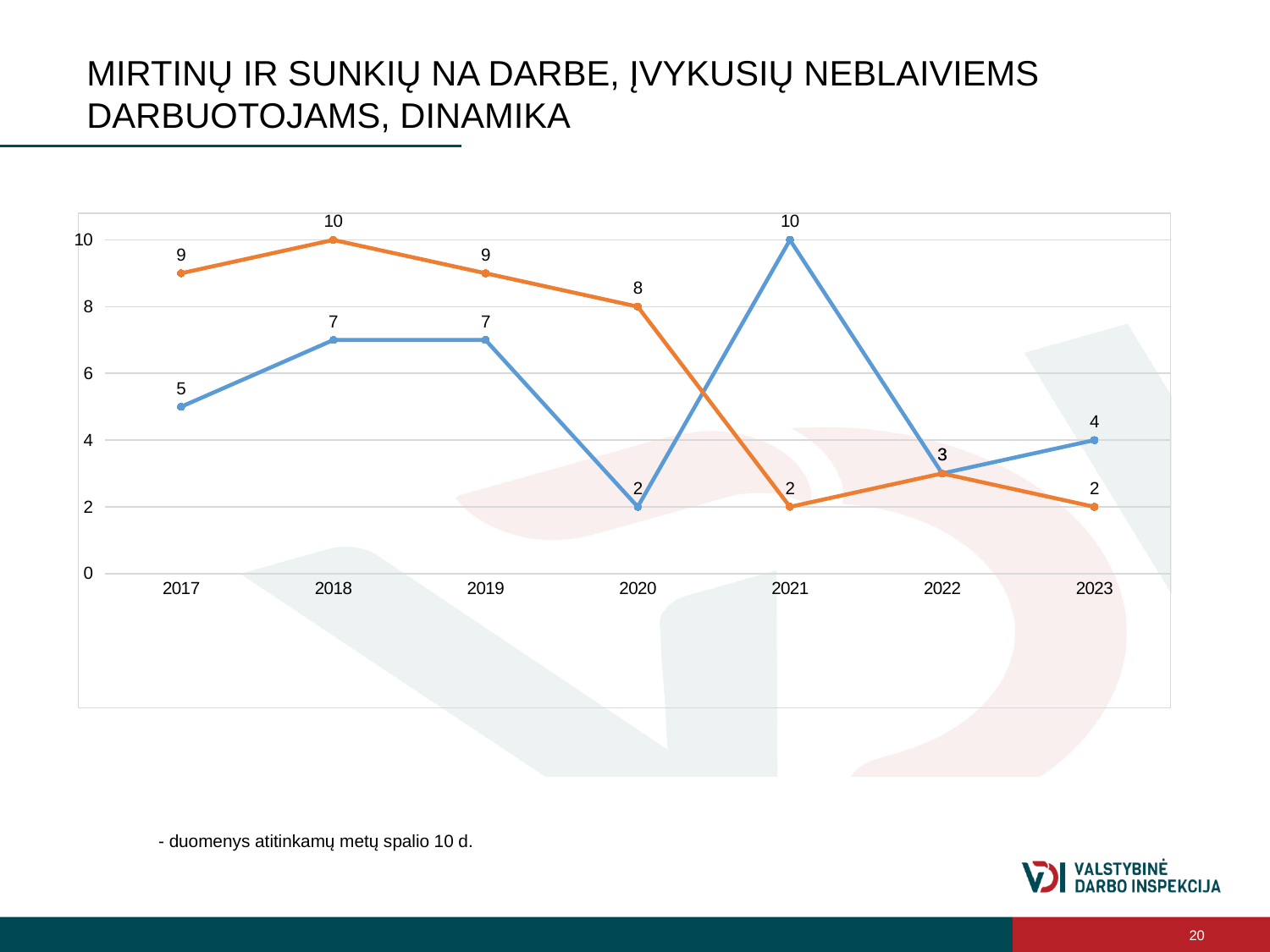
Which line has the larger value in 2021, the blue line or the orange line? blue line What is the difference between the orange line and the blue line in 2020? 6 What is the value of the orange line in 2018? 10 What kind of chart is shown on the slide? line chart In which year does the blue line reach its lowest value? 2020 What is the value of the orange line in 2023? 2 What is the first year shown on the x axis of the chart? 2017 What is the value of the blue line in 2021? 10 In which year does the orange line reach its highest value? 2018 Does the orange line rise or fall from 2018 to 2020? fall What is the value of the blue line in 2017? 5 How many years are plotted along the x axis of the chart? 7